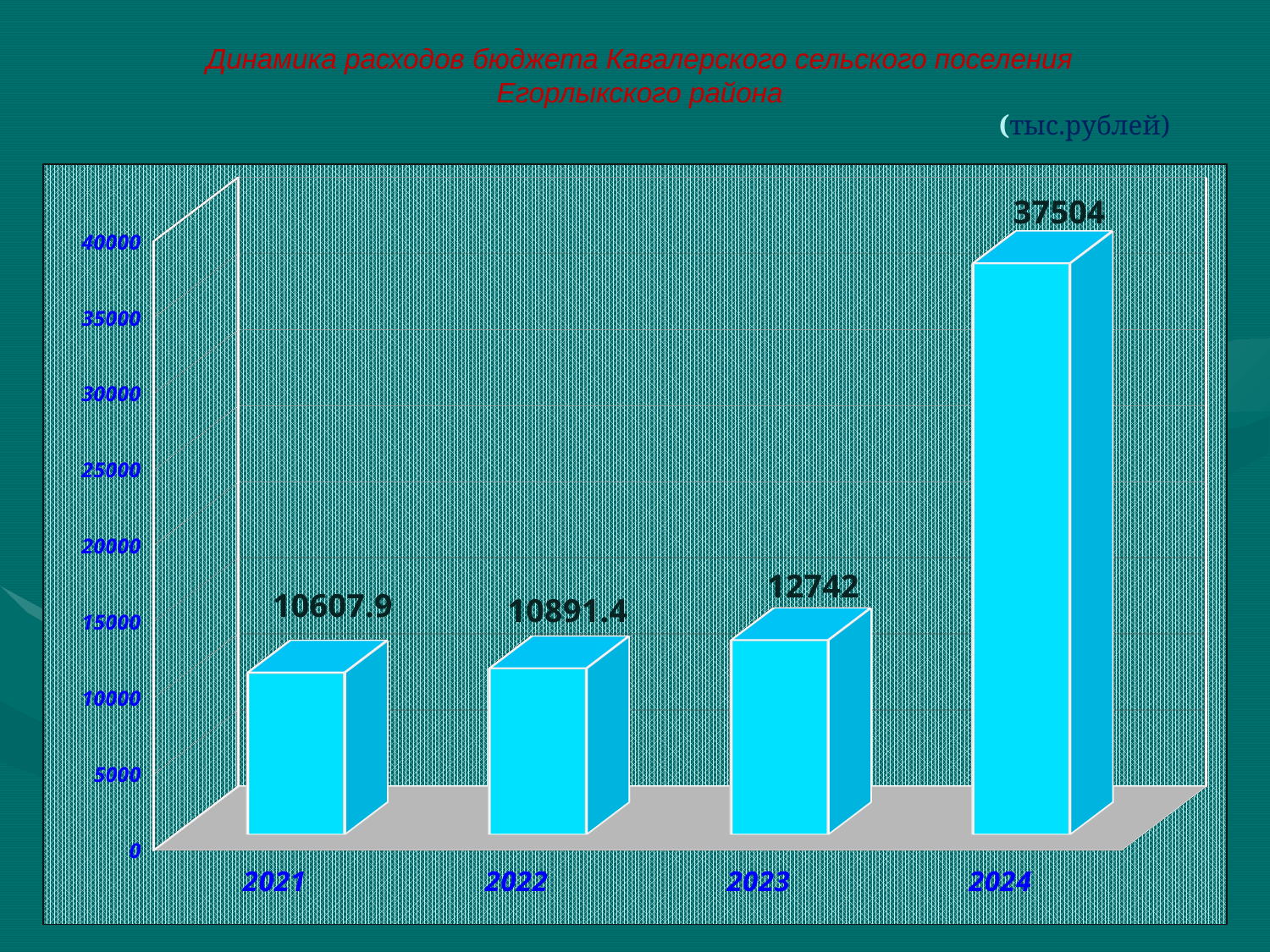
What is the value for 2023? 12742 Do the values rise or fall from 2021 to 2024? rise What is the difference between the values for 2022 and 2021? 283.5 Which year has the highest value? 2024 What is the value for 2024? 37504 What is the difference between the values for 2024 and 2023? 24762 What is the value for 2022? 10891.4 What kind of chart is this? bar chart How many years are shown on the chart? 4 What is the value for 2021? 10607.9 Which is larger, the value for 2023 or the value for 2022? 2023 Which year has the lowest value? 2021